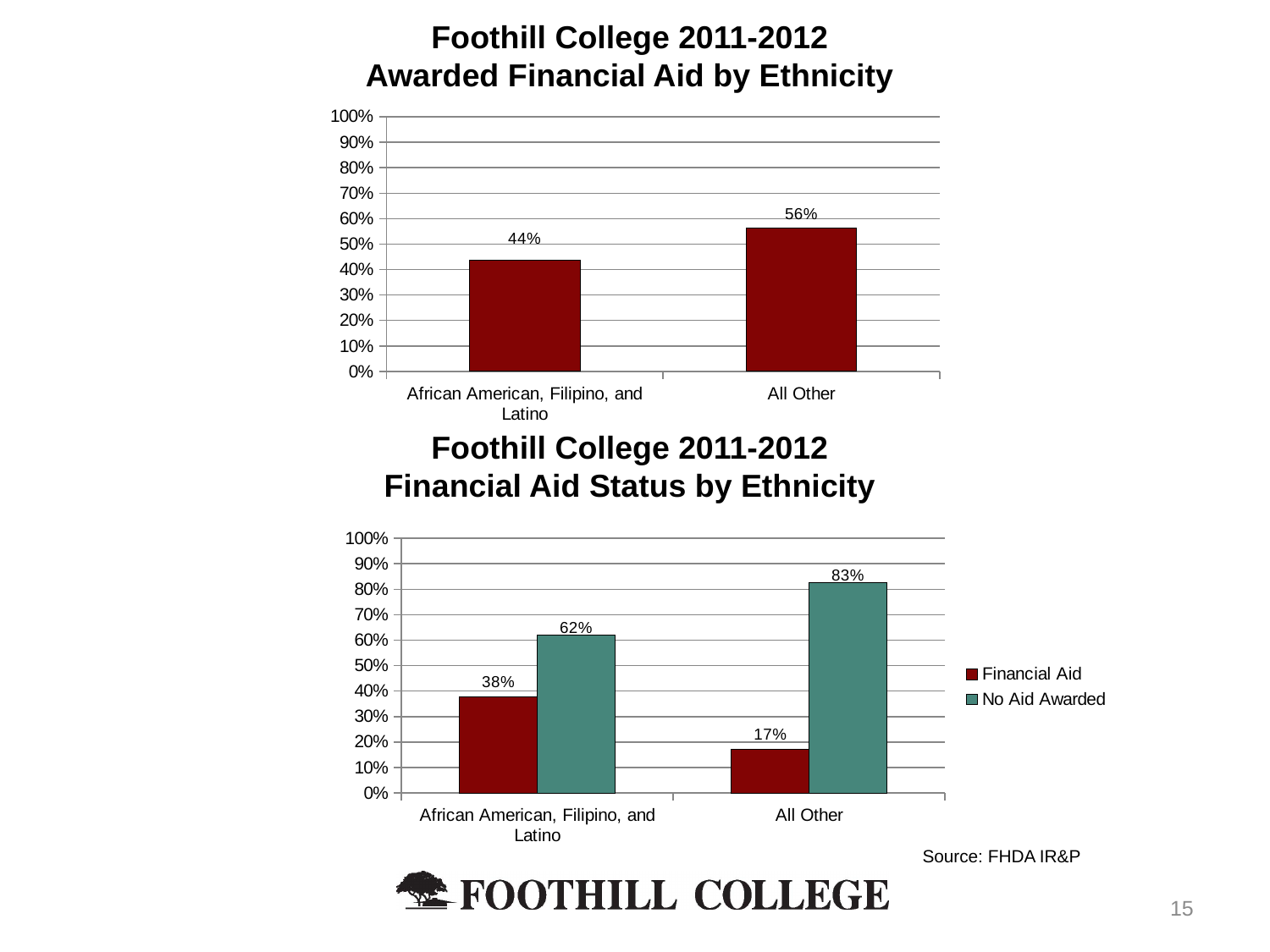
In the 'Financial Aid Status by Ethnicity' chart, how many series does the legend list? 2 In the 'Awarded Financial Aid by Ethnicity' chart, how many categories are shown? 2 In the 'Awarded Financial Aid by Ethnicity' chart, which category has the higher value? All Other What kind of chart is the 'Financial Aid Status by Ethnicity' chart? bar chart In the 'Financial Aid Status by Ethnicity' chart, what is the No Aid Awarded value for African American, Filipino, and Latino? 62% In the 'Awarded Financial Aid by Ethnicity' chart, what is the difference between All Other and African American, Filipino, and Latino? 12% In the 'Financial Aid Status by Ethnicity' chart, which category has the highest No Aid Awarded value? All Other In the 'Awarded Financial Aid by Ethnicity' chart, what is the value for African American, Filipino, and Latino? 44% In the 'Awarded Financial Aid by Ethnicity' chart, what is the value for All Other? 56% In the 'Financial Aid Status by Ethnicity' chart, what is the Financial Aid value for All Other? 17% In the 'Financial Aid Status by Ethnicity' chart, is the Financial Aid value for African American, Filipino, and Latino larger or smaller than the Financial Aid value for All Other? larger In the 'Financial Aid Status by Ethnicity' chart, what is the difference between the No Aid Awarded and Financial Aid values for All Other? 66%